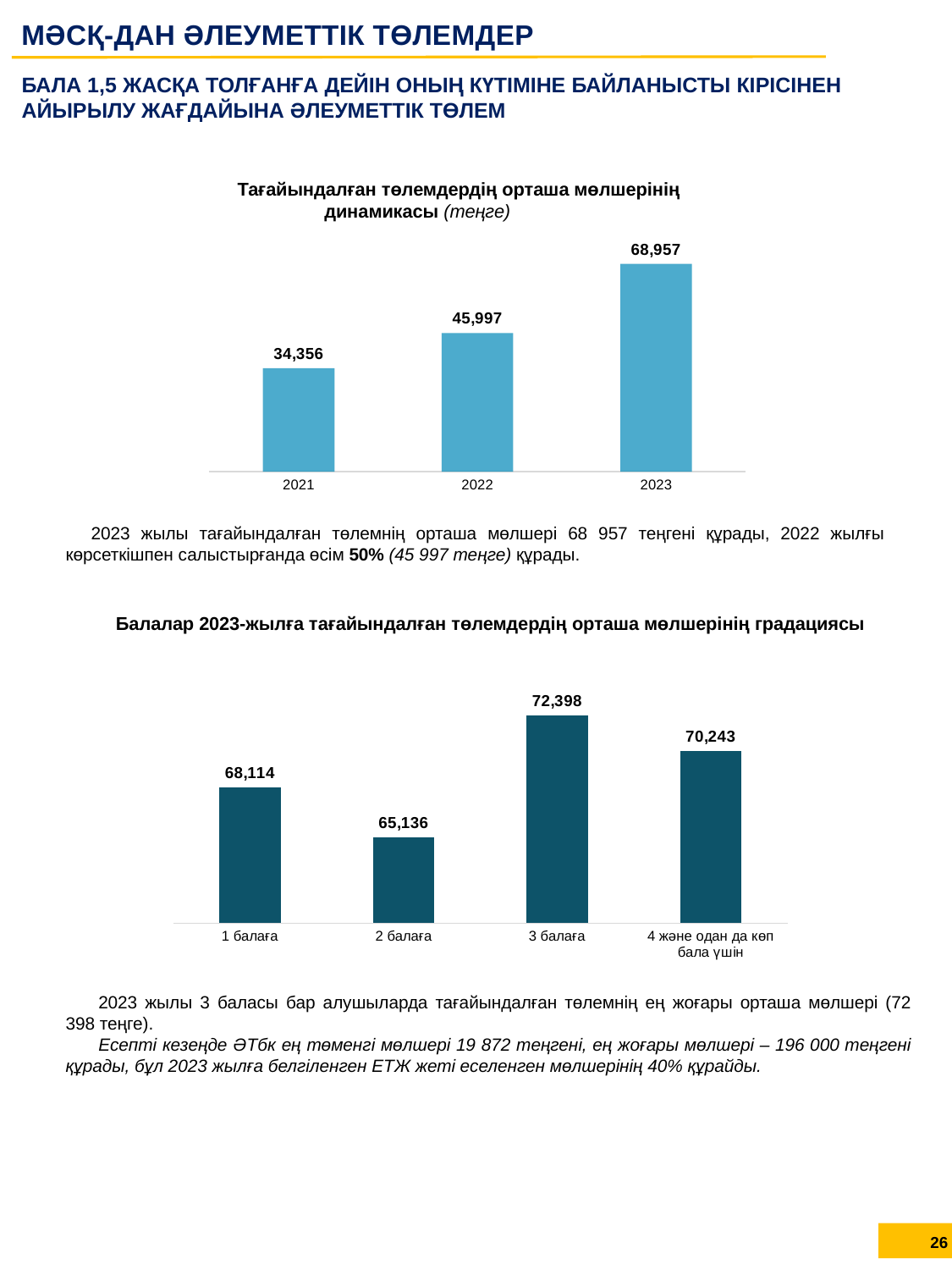
In the bottom chart (Балалар 2023-жылға тағайындалған төлемдердің орташа мөлшерінің градациясы), what is the value for 4 және одан да көп бала үшін? 70,243 In the top chart (Тағайындалған төлемдердің орташа мөлшерінің динамикасы), how many years are shown? 3 In the bottom chart (Балалар 2023-жылға тағайындалған төлемдердің орташа мөлшерінің градациясы), what is the value for 2 балаға? 65,136 In the top chart (Тағайындалған төлемдердің орташа мөлшерінің динамикасы), what is the difference between the 2023 and 2022 values? 22,960 In the bottom chart (Балалар 2023-жылға тағайындалған төлемдердің орташа мөлшерінің градациясы), which category has the highest value? 3 балаға What kind of chart is the bottom chart (Балалар 2023-жылға тағайындалған төлемдердің орташа мөлшерінің градациясы)? bar chart In the top chart (Тағайындалған төлемдердің орташа мөлшерінің динамикасы), what is the value for 2023? 68,957 In the top chart (Тағайындалған төлемдердің орташа мөлшерінің динамикасы), what is the value for 2021? 34,356 In the bottom chart (Балалар 2023-жылға тағайындалған төлемдердің орташа мөлшерінің градациясы), which is larger: the value for 1 балаға or for 2 балаға? 1 балаға In the bottom chart (Балалар 2023-жылға тағайындалған төлемдердің орташа мөлшерінің градациясы), what is the difference between the values for 3 балаға and 1 балаға? 4,284 In the top chart (Тағайындалған төлемдердің орташа мөлшерінің динамикасы), do the values rise or fall from 2021 to 2023? rise In the top chart (Тағайындалған төлемдердің орташа мөлшерінің динамикасы), which year has the lowest value? 2021